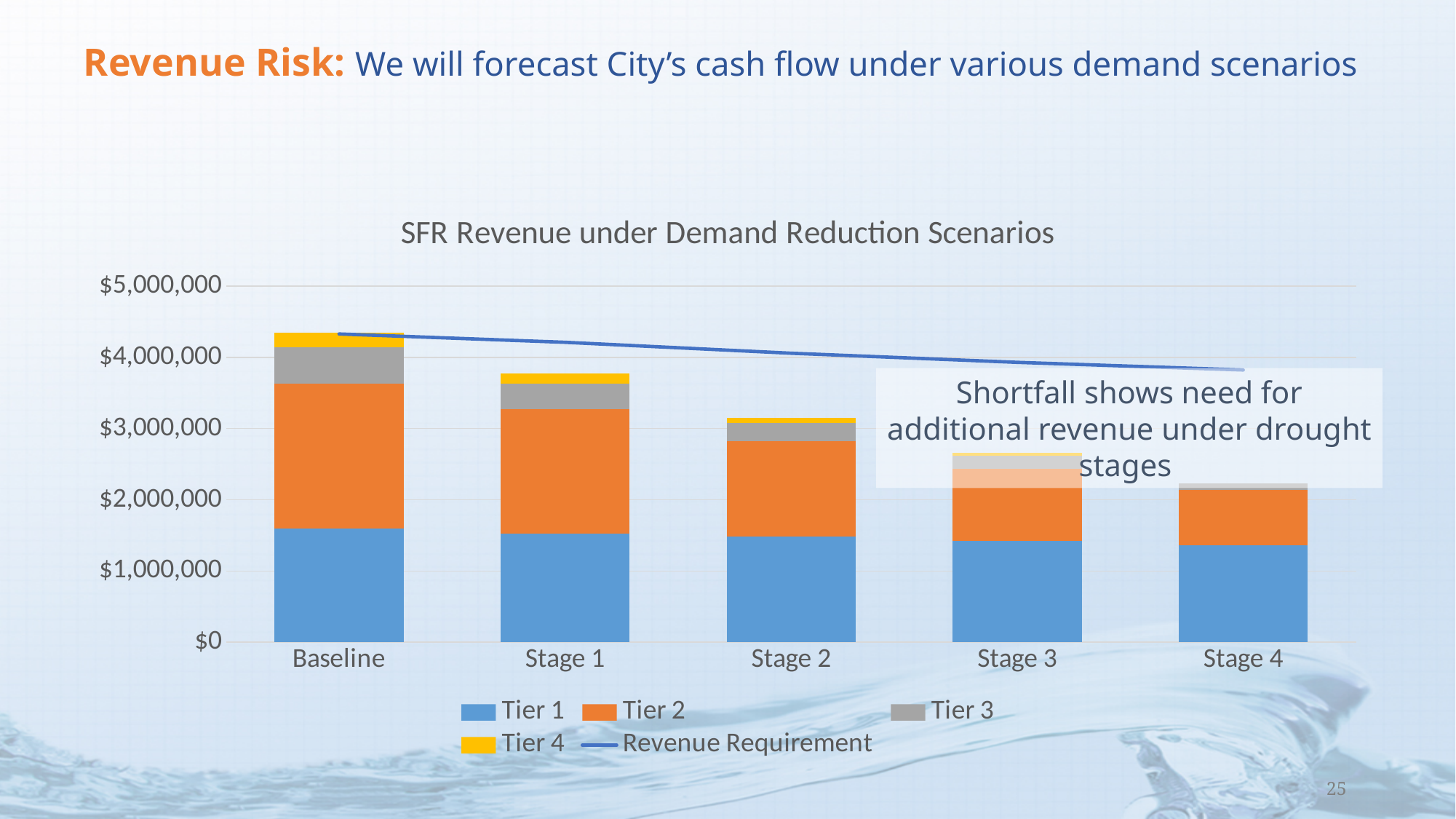
Is the total revenue for Stage 3 greater or less than $3,000,000? less Is the total revenue for Stage 1 greater or less than $4,000,000? less Which scenario has the highest total SFR revenue? Baseline Which is larger, the total revenue for Stage 1 or for Stage 3? Stage 1 Do the total revenue bars rise or fall from Baseline to Stage 4? Fall How many scenario categories are shown on the x axis? 5 Which scenario has the lowest total SFR revenue? Stage 4 What type of chart is shown on the slide? Stacked bar chart combined with a line (combination chart) What is the title of the chart? SFR Revenue under Demand Reduction Scenarios Is the total revenue for Baseline greater or less than $4,000,000? greater How many series does the legend list? 5